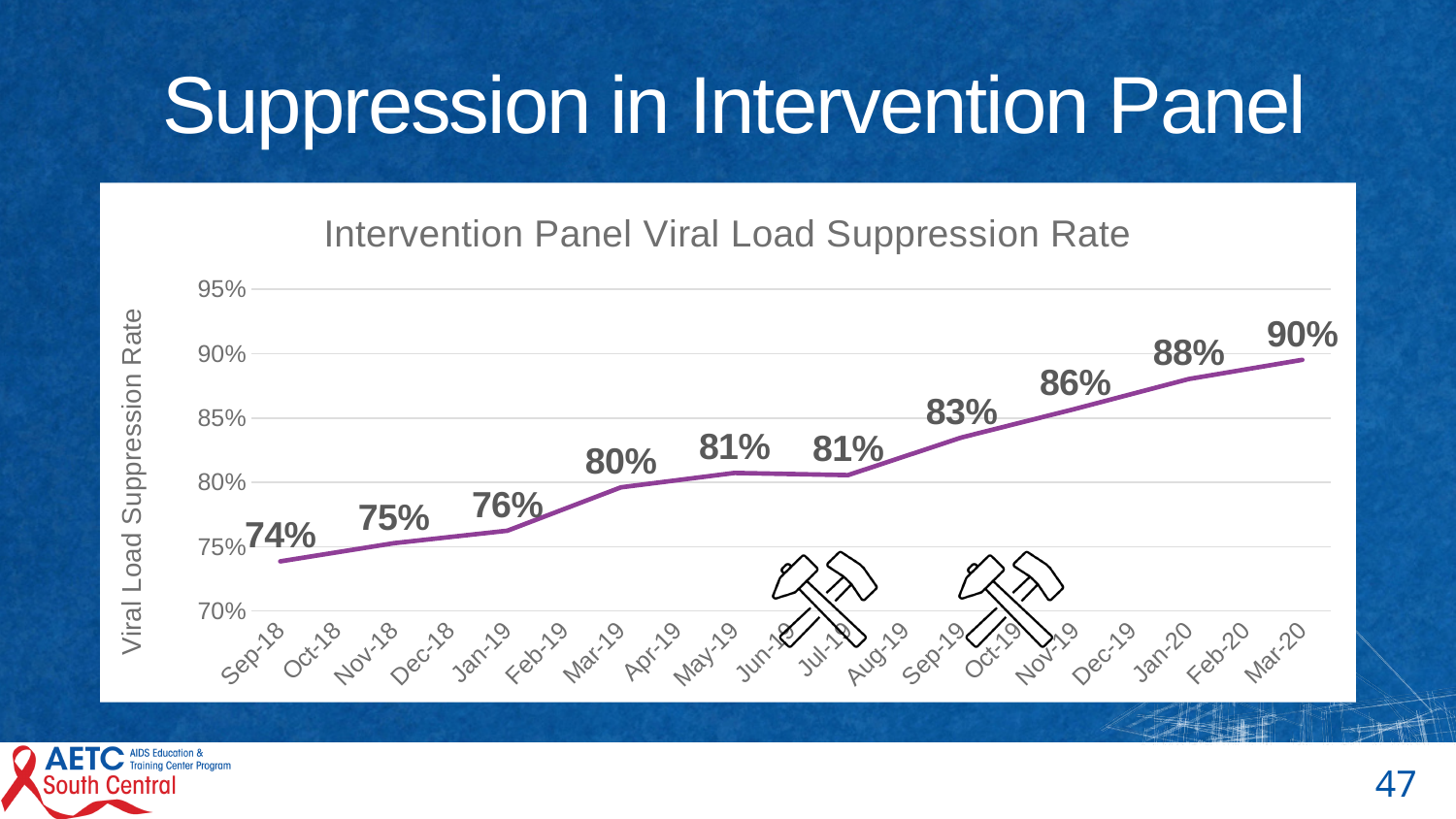
What kind of chart is shown on the slide? Line chart What is the viral load suppression rate for Mar-20? 90% How many months are shown on the x axis? 19 Is the value for Dec-18 greater or less than 80%? less Which month has the lowest viral load suppression rate? Sep-18 What is the viral load suppression rate for Nov-19? 86% What is the viral load suppression rate for Sep-18? 74% What is the viral load suppression rate for Mar-19? 80% Does the viral load suppression rate rise or fall from Sep-18 to Mar-20? Rise Which is higher, the suppression rate in Jan-20 or in Sep-19? Jan-20 Which month has the highest viral load suppression rate? Mar-20 By how many percentage points did the suppression rate increase from Sep-18 to Mar-20? 16 percentage points